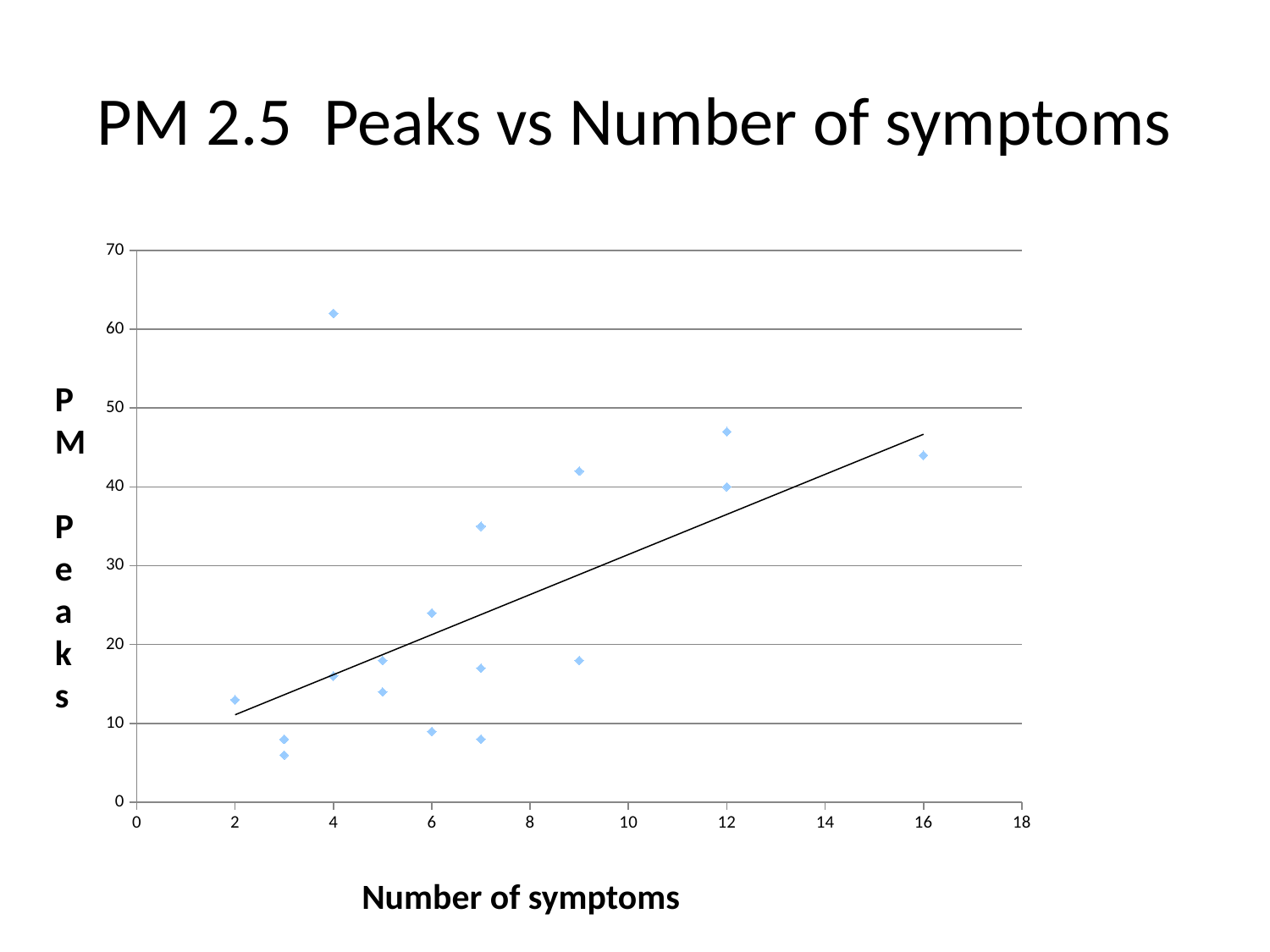
What kind of chart is shown on the slide? scatter chart Is the highest PM peak value plotted greater or less than 60? greater Are the PM peak values for 3 symptoms greater or less than 10? less At which number of symptoms does the highest PM peak occur? 4 Does the trend line rise or fall as the number of symptoms increases? rises What is the label of the x axis? Number of symptoms What is the highest value shown on the y axis? 70 What is the title of the chart? PM 2.5 Peaks vs Number of symptoms Is the PM peak value for 16 symptoms greater or less than 40? greater